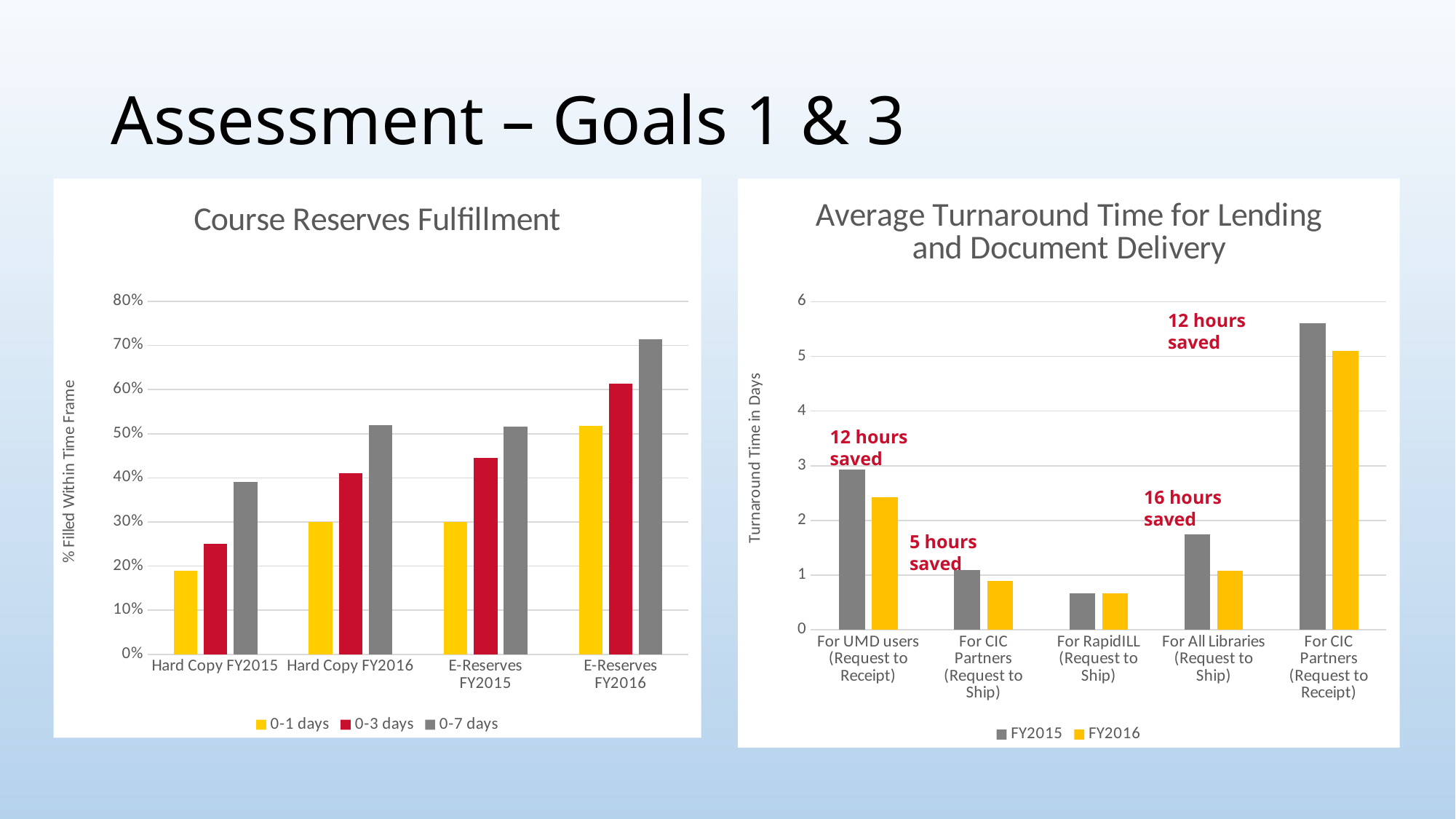
In the 'Average Turnaround Time for Lending and Document Delivery' chart, which category has the highest FY2015 value? For CIC Partners (Request to Receipt) In the 'Course Reserves Fulfillment' chart, for Hard Copy FY2015, which is larger: the 0-1 days value or the 0-3 days value? 0-3 days What kind of chart is the 'Course Reserves Fulfillment' chart? bar chart In the 'Average Turnaround Time for Lending and Document Delivery' chart, what annotation is shown above the bars for All Libraries (Request to Ship)? 16 hours saved In the 'Average Turnaround Time for Lending and Document Delivery' chart, is the FY2015 value for CIC Partners (Request to Receipt) greater or less than 5? greater How many series does the legend of the 'Course Reserves Fulfillment' chart list? 3 In the 'Course Reserves Fulfillment' chart, which category has the highest value for the 0-7 days series? E-Reserves FY2016 How many categories are shown on the x axis of the 'Course Reserves Fulfillment' chart? 4 In the 'Course Reserves Fulfillment' chart, is the 0-7 days value for E-Reserves FY2016 greater or less than 70%? greater How many categories are shown on the x axis of the 'Average Turnaround Time for Lending and Document Delivery' chart? 5 In the 'Course Reserves Fulfillment' chart, do the 0-3 days values rise or fall from Hard Copy FY2015 to E-Reserves FY2016? rise How many series does the legend of the 'Average Turnaround Time for Lending and Document Delivery' chart list? 2